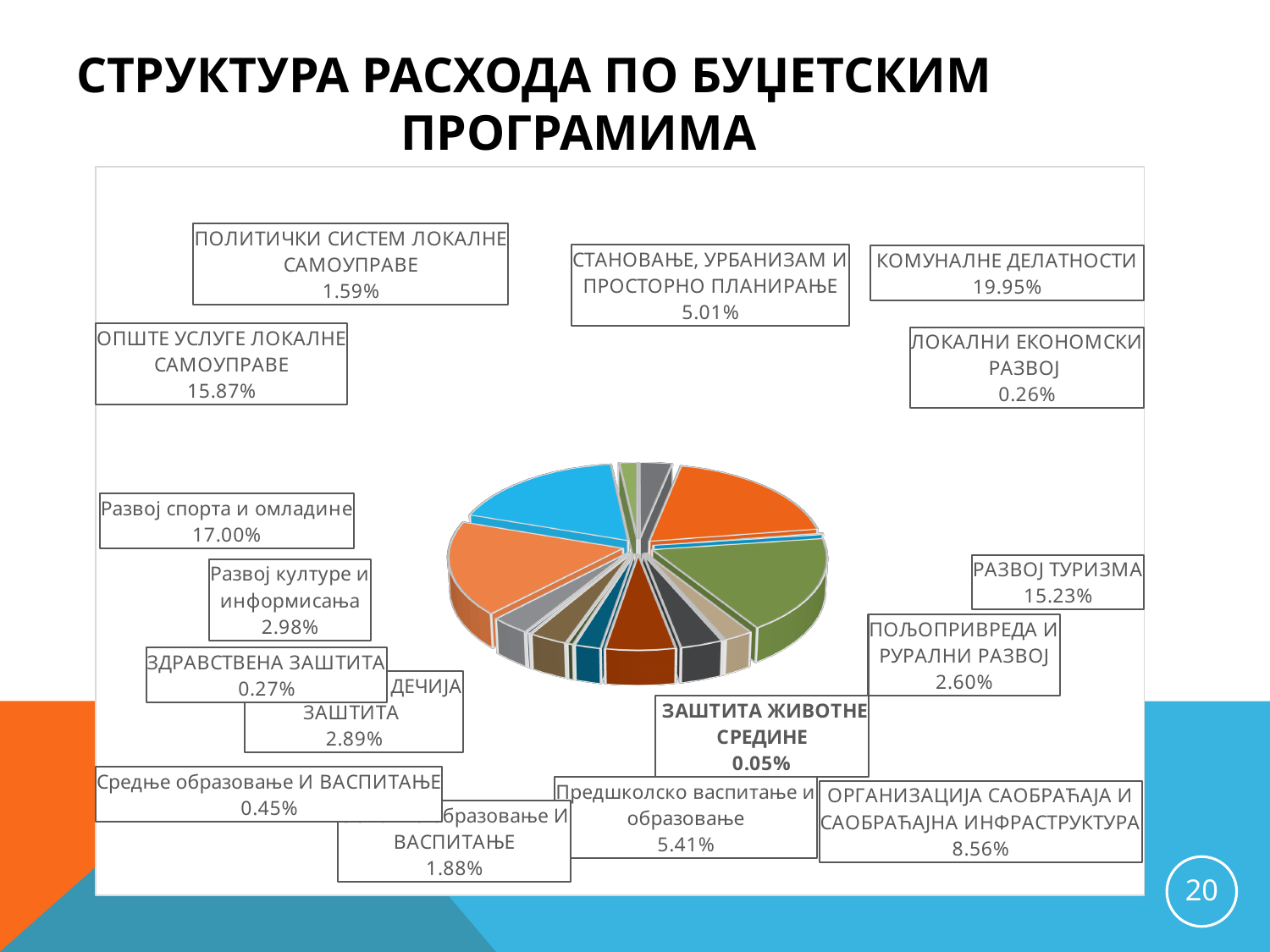
Which budget programme has the smallest share of expenditure? ЗАШТИТА ЖИВОТНЕ СРЕДИНЕ What share is shown for ЗАШТИТА ЖИВОТНЕ СРЕДИНЕ? 0.05% What type of chart is shown on the slide? Pie chart What is the difference in percentage points between КОМУНАЛНЕ ДЕЛАТНОСТИ and Развој спорта и омладине? 2.95% What percentage is labelled for ОРГАНИЗАЦИЈА САОБРАЋАЈА И САОБРАЋАЈНА ИНФРАСТРУКТУРА? 8.56% What is the value for РАЗВОЈ ТУРИЗМА? 15.23% Which budget programme has the largest share of expenditure? КОМУНАЛНЕ ДЕЛАТНОСТИ What is the title of the slide containing the chart? СТРУКТУРА РАСХОДА ПО БУЏЕТСКИМ ПРОГРАМИМА What share of expenditure goes to КОМУНАЛНЕ ДЕЛАТНОСТИ? 19.95% Which has a larger share: Предшколско васпитање и образовање or СТАНОВАЊЕ, УРБАНИЗАМ И ПРОСТОРНО ПЛАНИРАЊЕ? Предшколско васпитање и образовање What is the difference between ОПШТЕ УСЛУГЕ ЛОКАЛНЕ САМОУПРАВЕ and РАЗВОЈ ТУРИЗМА? 0.64% What percentage is shown for Развој спорта и омладине? 17.00%